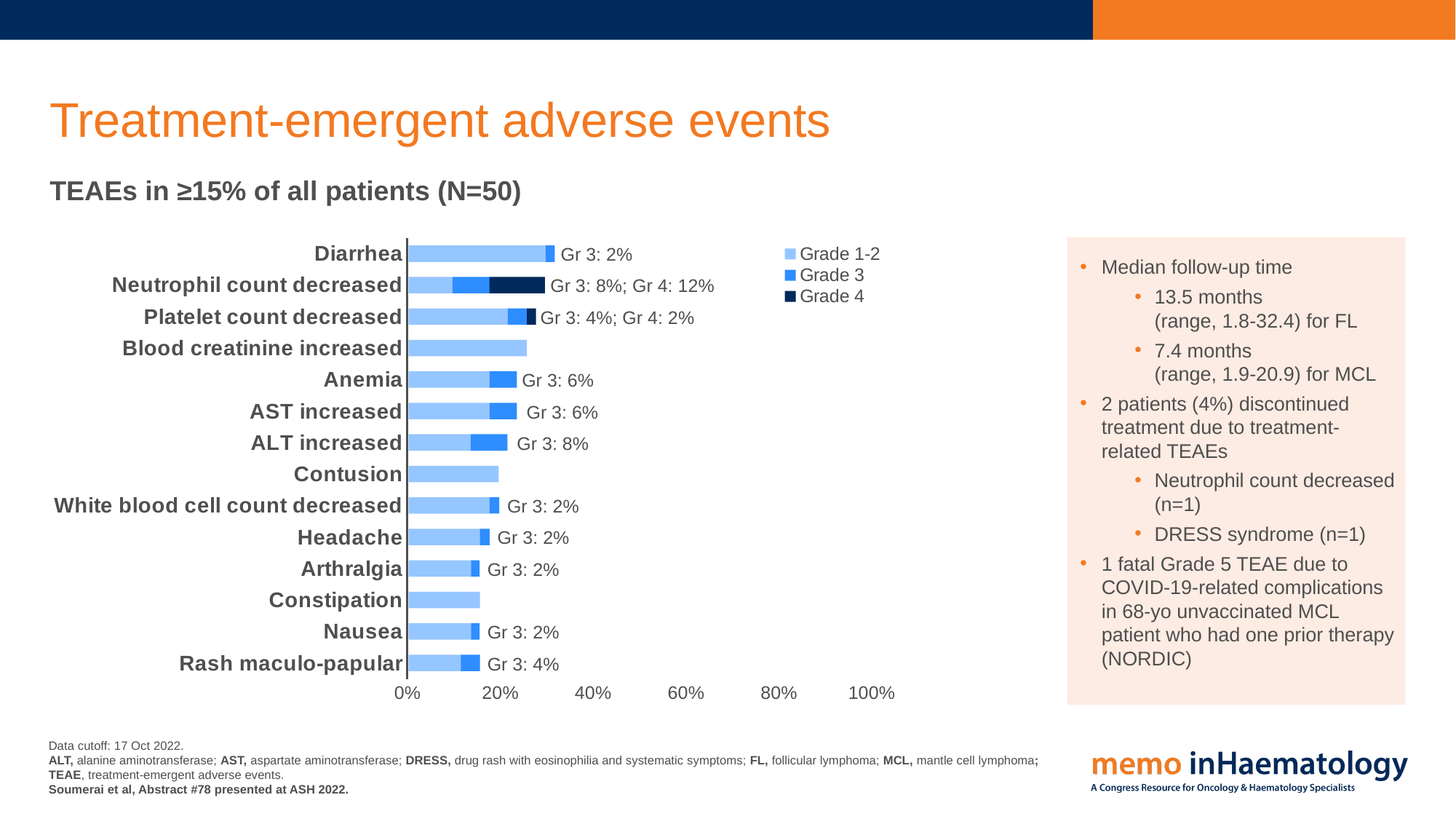
What is the Grade 3 percentage shown for Rash maculo-papular? 4% How many series does the chart legend list? 3 What is the Grade 3 percentage shown for Anemia? 6% How many adverse event categories are plotted in the chart? 14 Is the total bar for Diarrhea greater or less than 20%? greater What is the Grade 4 percentage shown for Platelet count decreased? 2% Which has a larger Grade 3 percentage, Neutrophil count decreased or Anemia? Neutrophil count decreased What kind of chart is shown on the slide? Stacked bar chart Is the total bar for Constipation greater or less than 20%? less What is the Grade 4 percentage shown for Neutrophil count decreased? 12% What is the Grade 3 percentage shown for Neutrophil count decreased? 8% What is the difference between the Grade 4 percentage for Neutrophil count decreased and the Grade 4 percentage for Platelet count decreased? 10%